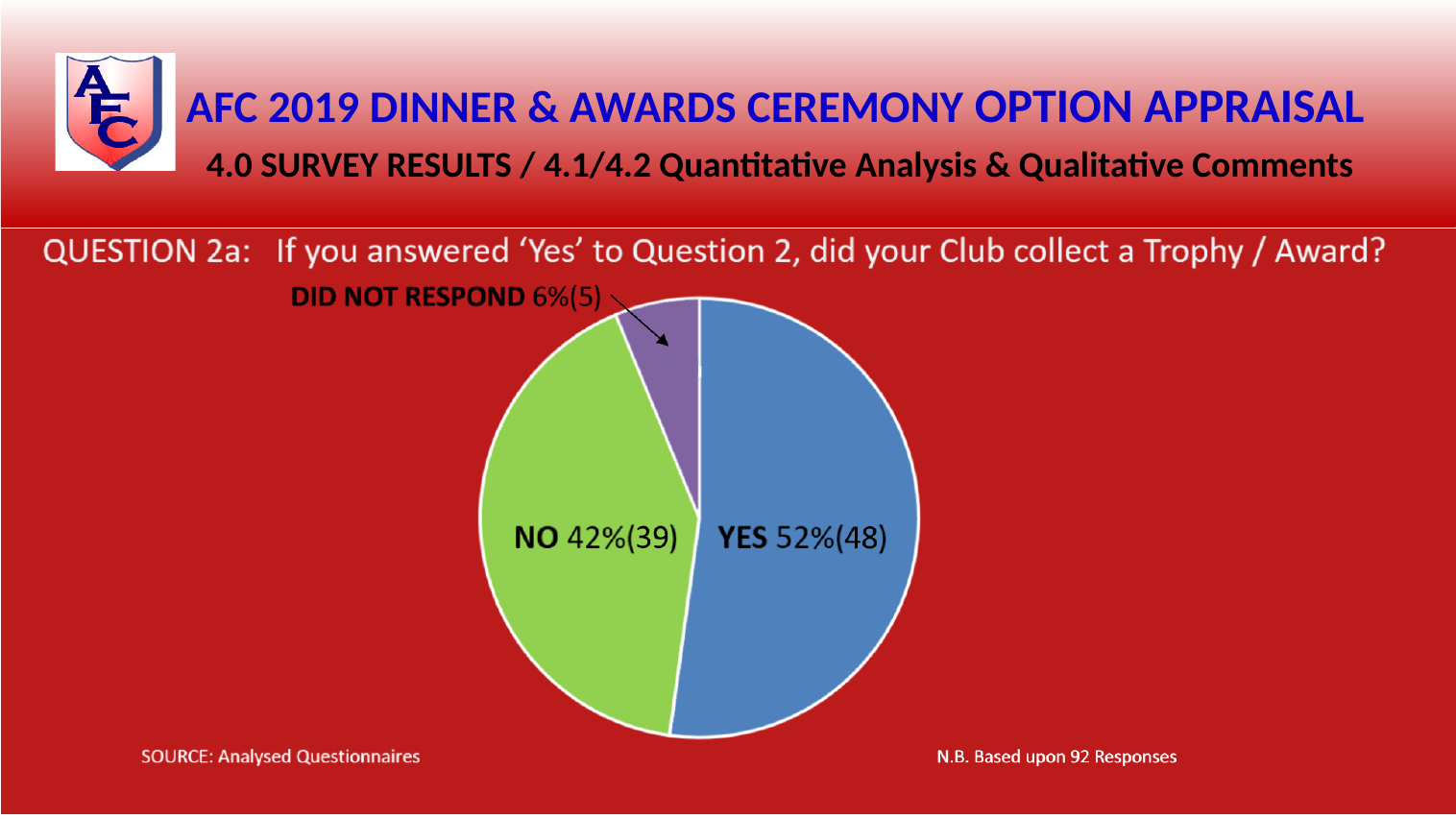
What colour is the YES slice? blue How many respondents are in the DID NOT RESPOND slice? 5 Which slice of the pie is the smallest? DID NOT RESPOND Which slice of the pie is the largest? YES What is the difference in percentage points between YES and NO? 10 How many slices does the pie chart have? 3 What percentage of respondents DID NOT RESPOND? 6% How many respondents answered NO? 39 How many responses is the chart based upon, according to the note on the slide? 92 What percentage of respondents answered YES? 52% What kind of chart is shown on the slide? pie chart Which is larger, the NO slice or the DID NOT RESPOND slice? NO